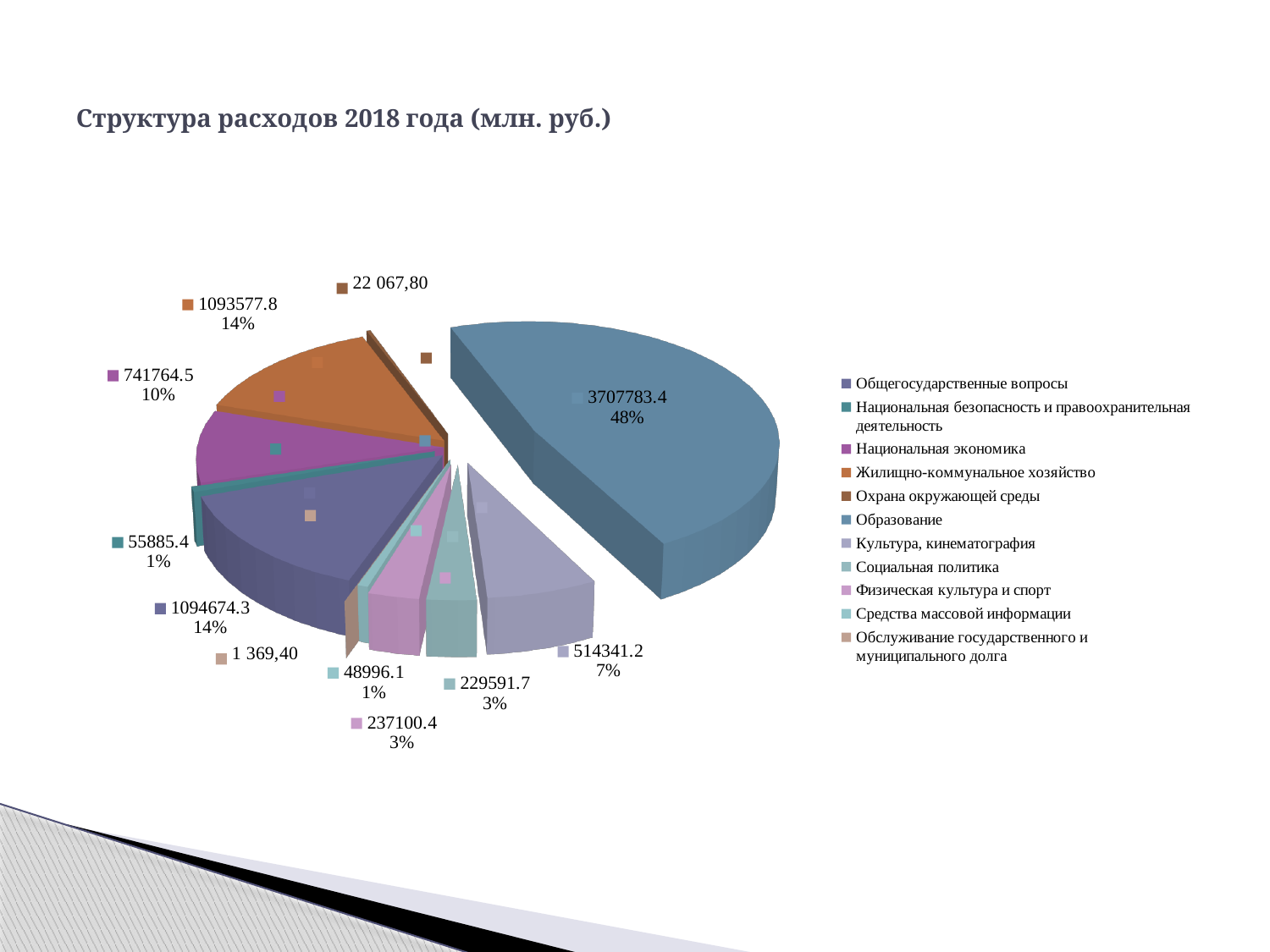
Which category has the largest slice of the pie? Образование What share of the pie does Национальная экономика account for? 10% What kind of chart is shown on the slide? pie chart What share of the pie does Образование account for? 48% How many categories does the legend of the pie chart list? 11 Which category has the smallest slice of the pie? Обслуживание государственного и муниципального долга What is the value shown for Жилищно-коммунальное хозяйство? 1093577.8 What is the title of the chart? Структура расходов 2018 года (млн. руб.) What is the difference between the values for Культура, кинематография and Социальная политика? 284749.5 What is the value shown for Культура, кинематография? 514341.2 Which is larger, the value for Национальная экономика or the value for Культура, кинематография? Национальная экономика What is the value shown for Образование? 3707783.4